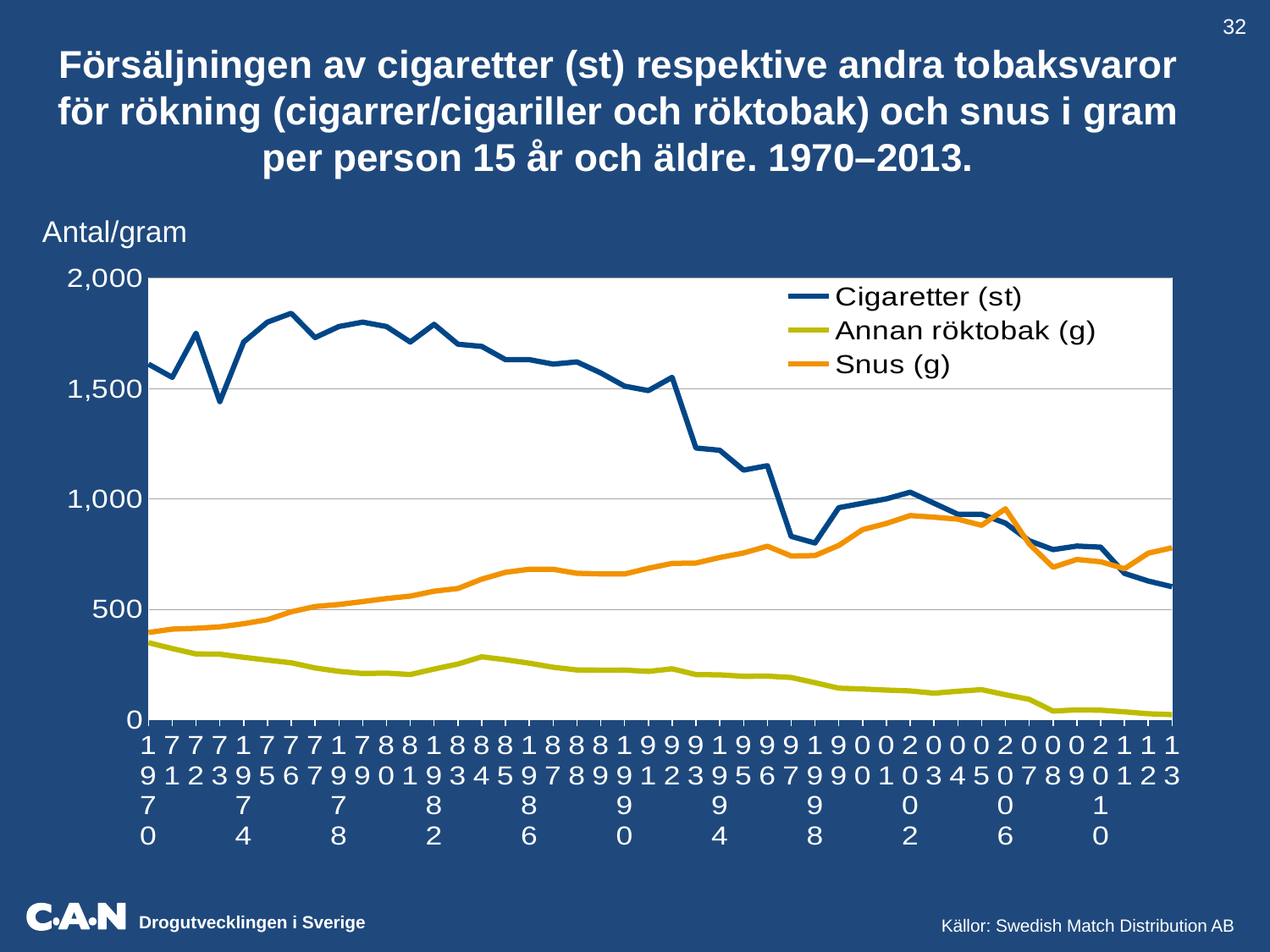
Is the value for Annan röktobak (g) in 2013 greater or less than 500? less Is the value for Snus (g) in 1970 greater or less than 500? less Is the value for Cigaretter (st) in 1970 greater or less than 1,500? greater What are the three series named in the legend? Cigaretter (st), Annan röktobak (g), Snus (g) Does the Snus (g) series rise or fall overall from 1970 to 2013? rise How many series does the legend list? 3 What type of chart is shown on the slide? line chart Which series has the lowest value in 2013? Annan röktobak (g) Which is larger in 1990, Snus (g) or Annan röktobak (g)? Snus (g) What is the label shown above the vertical axis? Antal/gram Does the Cigaretter (st) series rise or fall overall from 1970 to 2013? fall Which is larger in 2013, Cigaretter (st) or Snus (g)? Snus (g)